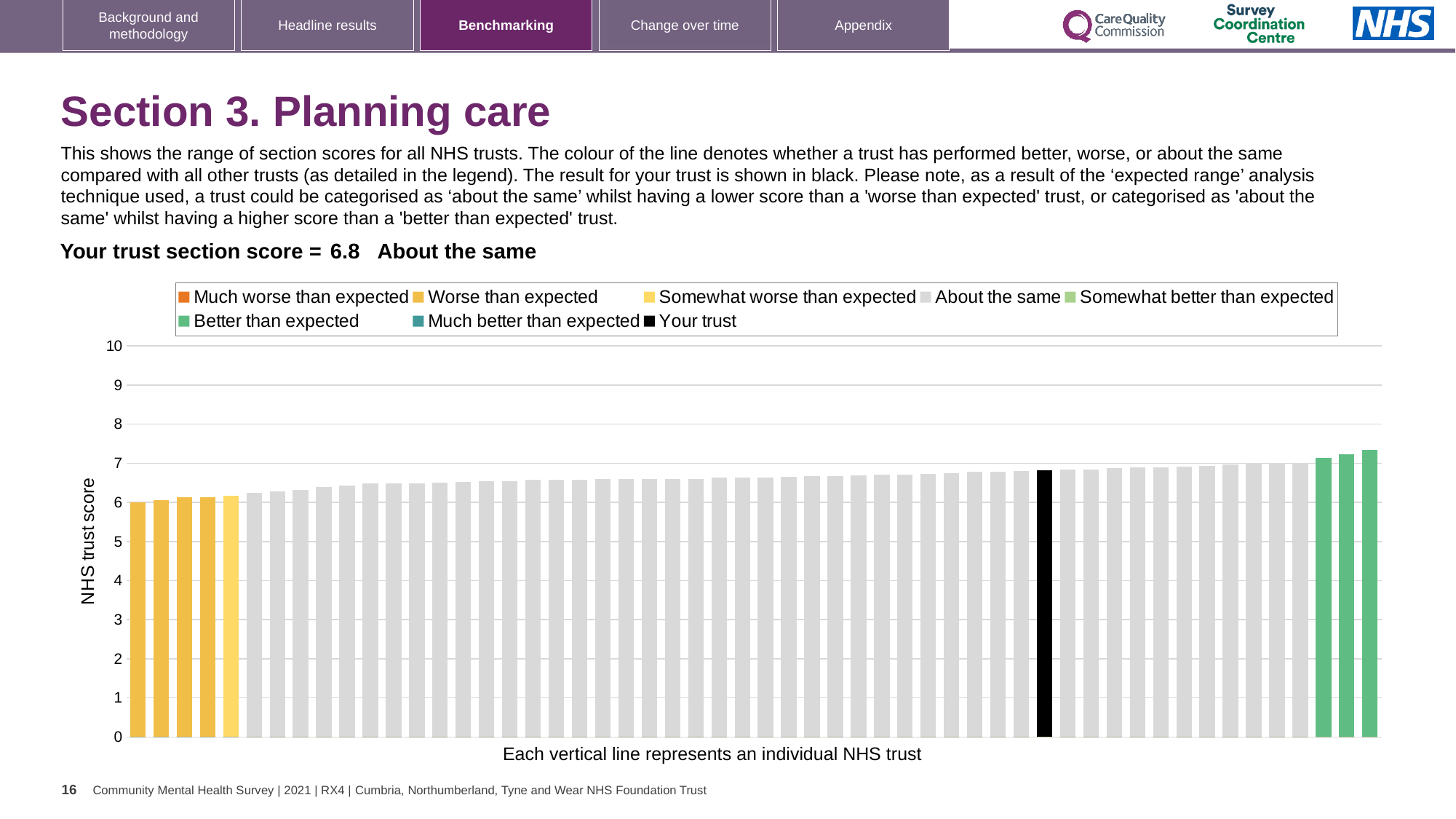
Do the bar values rise or fall from left to right along the x axis? rise What is the label on the y axis of the chart? NHS trust score What is the section score for your trust shown on the slide? 6.8 What kind of chart is shown on the slide? bar chart Is the value for your trust greater or less than 7? less Is the value for your trust (the black bar) greater or less than 5? greater Which benchmarking category is your trust placed in for Section 3. Planning care? About the same Is the value of the tallest bar in the chart greater or less than 8? less How many bars are coloured green (better than expected)? 3 How many entries does the chart legend list? 8